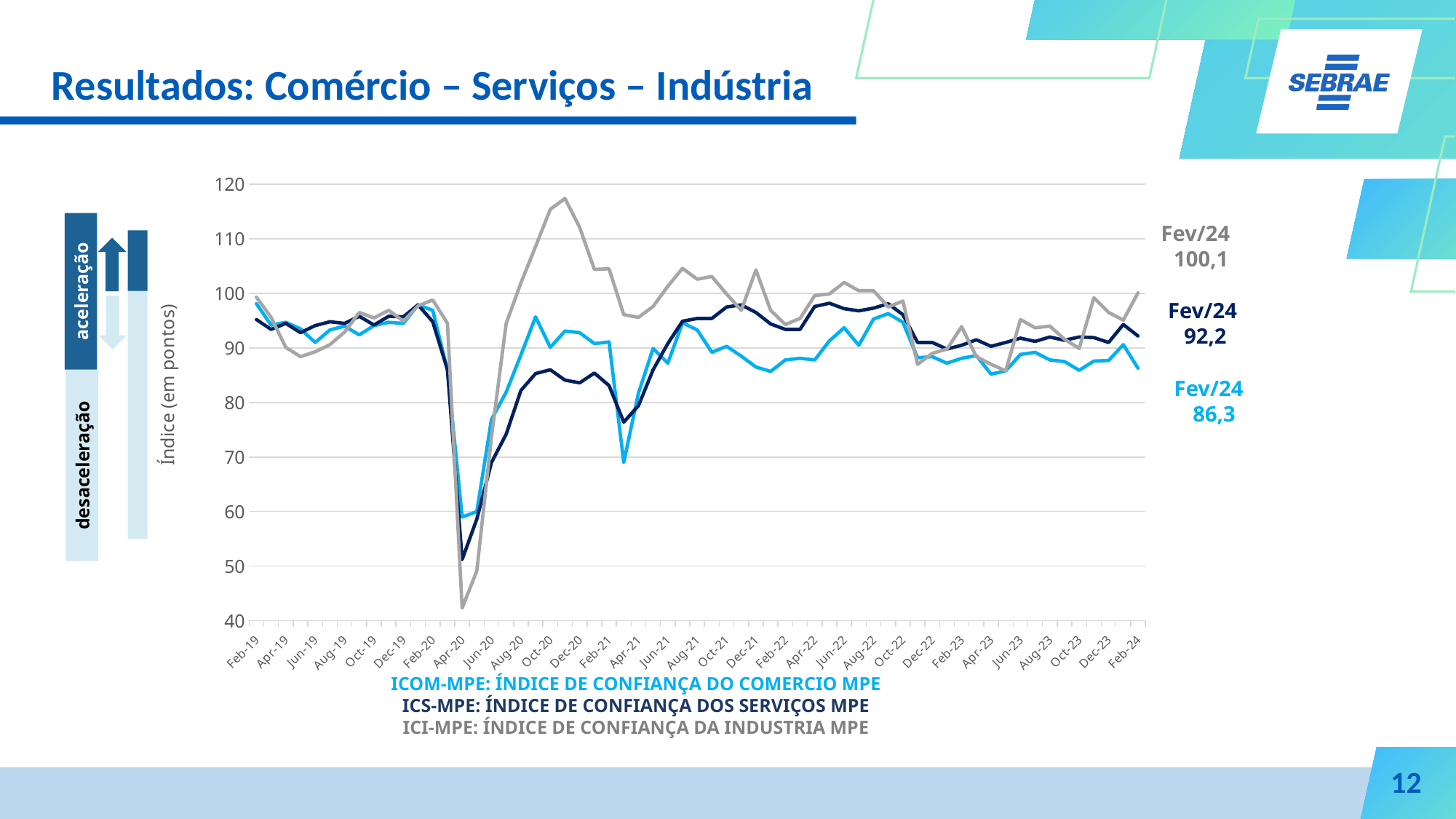
Which index has the highest value in Fev/24? ICI-MPE What is the Fev/24 value of ICS-MPE (Índice de Confiança dos Serviços MPE)? 92,2 What kind of chart is shown on the slide? line chart In Fev/24, which is larger: ICS-MPE or ICOM-MPE? ICS-MPE Which index has the lowest value in Fev/24? ICOM-MPE How many series does the chart legend list? 3 Is the lowest value of the ICI-MPE line (around Apr-20) greater or less than 50? less What is the Fev/24 value of ICOM-MPE (Índice de Confiança do Comercio MPE)? 86,3 What is the difference between the Fev/24 values of ICI-MPE and ICS-MPE? 7,9 What is the difference between the Fev/24 values of ICI-MPE and ICOM-MPE? 13,8 What is the label of the vertical axis? Índice (em pontos) What is the Fev/24 value of ICI-MPE (Índice de Confiança da Industria MPE)? 100,1